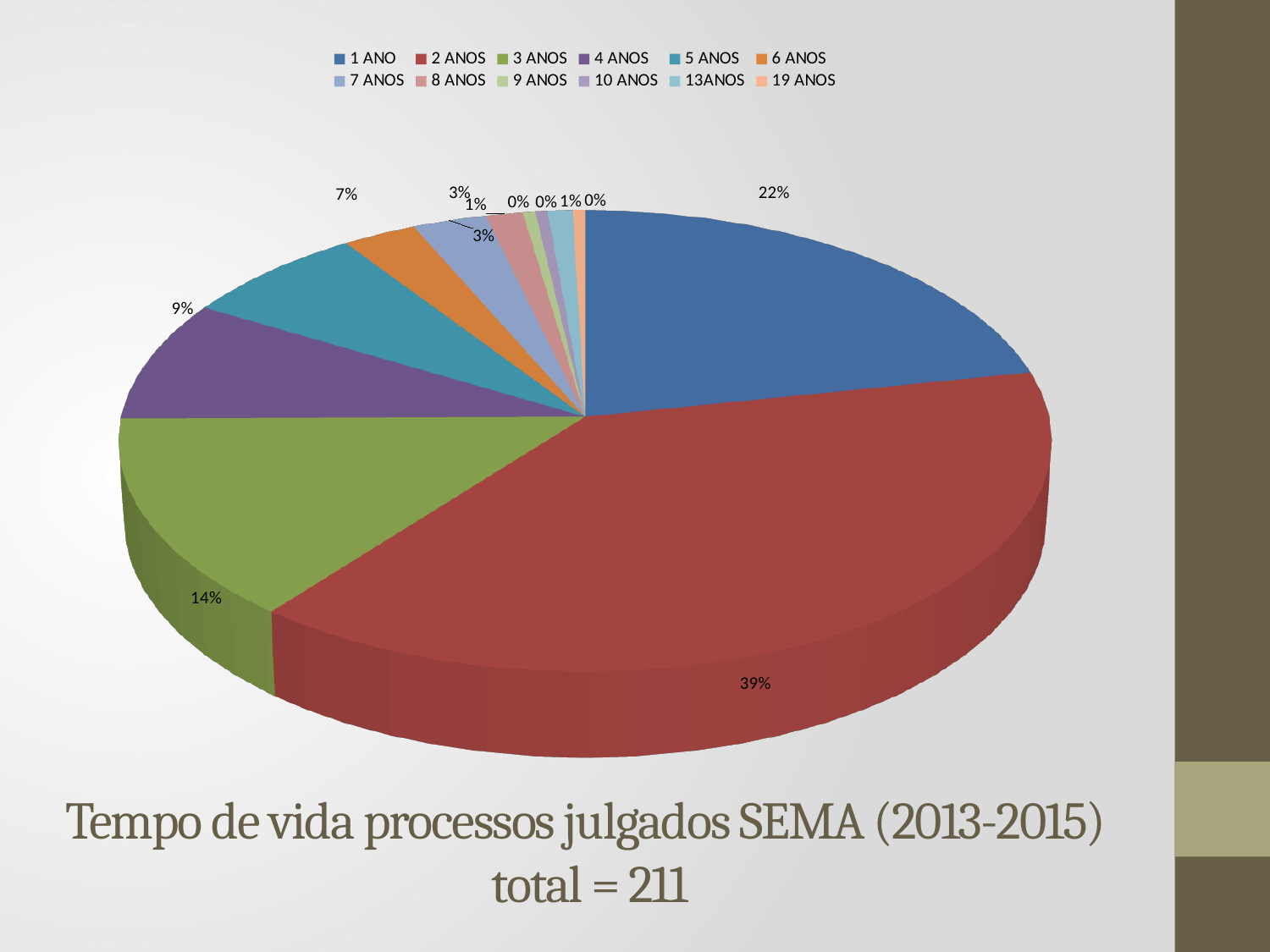
What kind of chart is shown on the slide? Pie chart What share of the pie does 5 ANOS represent? 7% What is the difference in percentage points between the shares for 2 ANOS and 1 ANO? 17 Which category has the largest share of the pie? 2 ANOS What share of the pie does 4 ANOS represent? 9% What is the title of the chart? Tempo de vida processos julgados SEMA (2013-2015) total = 211 What share of the pie does 2 ANOS represent? 39% How many categories does the legend list? 12 What total number of processes does the chart title state? 211 Which is larger, the share for 1 ANO or the share for 3 ANOS? 1 ANO